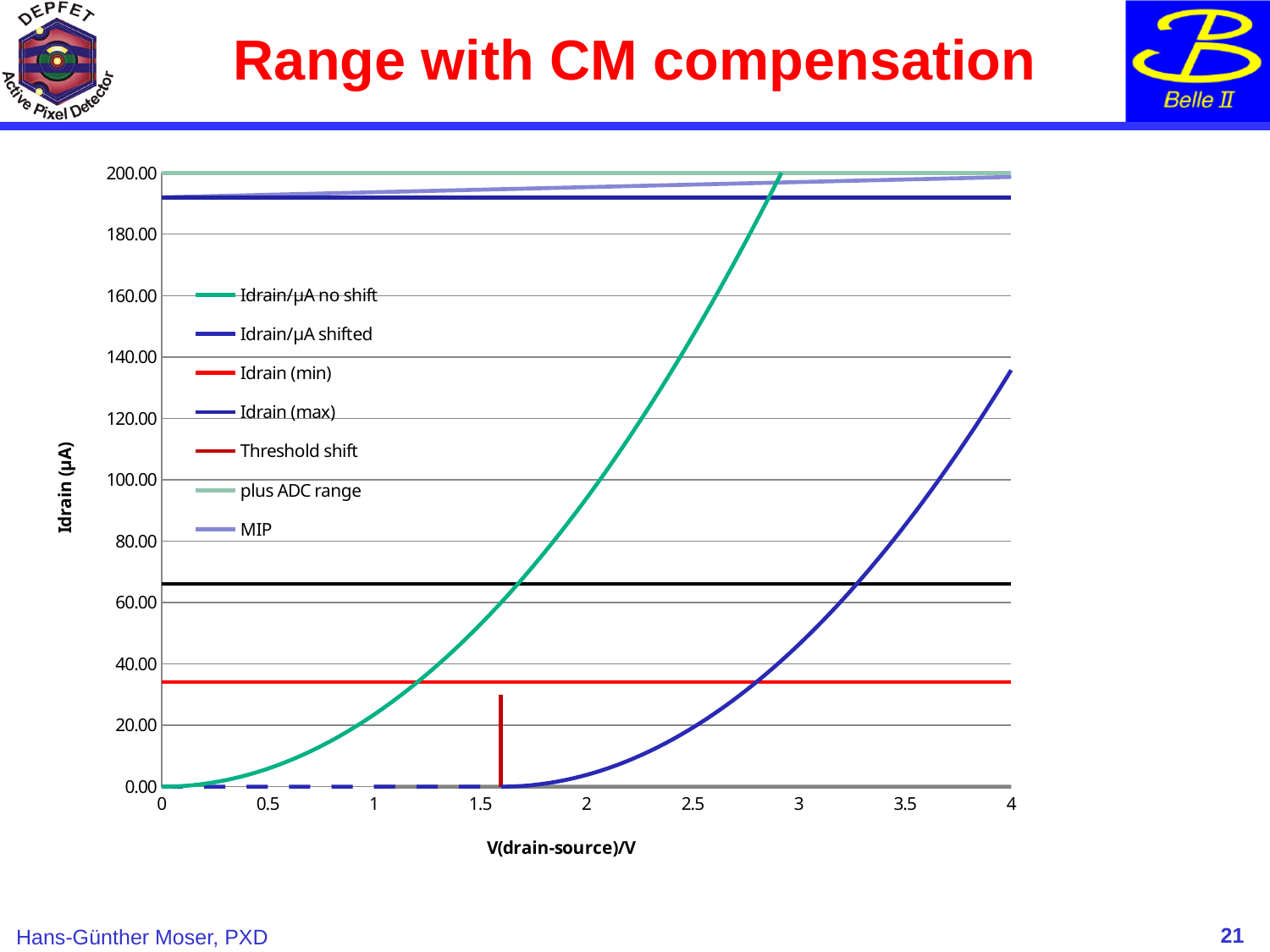
What is the title of the chart? Range with CM compensation Does the Idrain/µA shifted series rise or fall as V(drain-source) increases? rise Is the value of Idrain/µA shifted at V(drain-source) = 4 greater or less than 120? greater What is the label of the x axis? V(drain-source)/V Is the value of the Idrain (max) line greater or less than 180? greater How many series does the legend list? 7 Is the value of Idrain/µA no shift at V(drain-source) = 1 greater or less than 40? less At V(drain-source) = 3, which series is higher: Idrain/µA no shift or Idrain/µA shifted? Idrain/µA no shift What kind of chart is shown on the slide? line chart